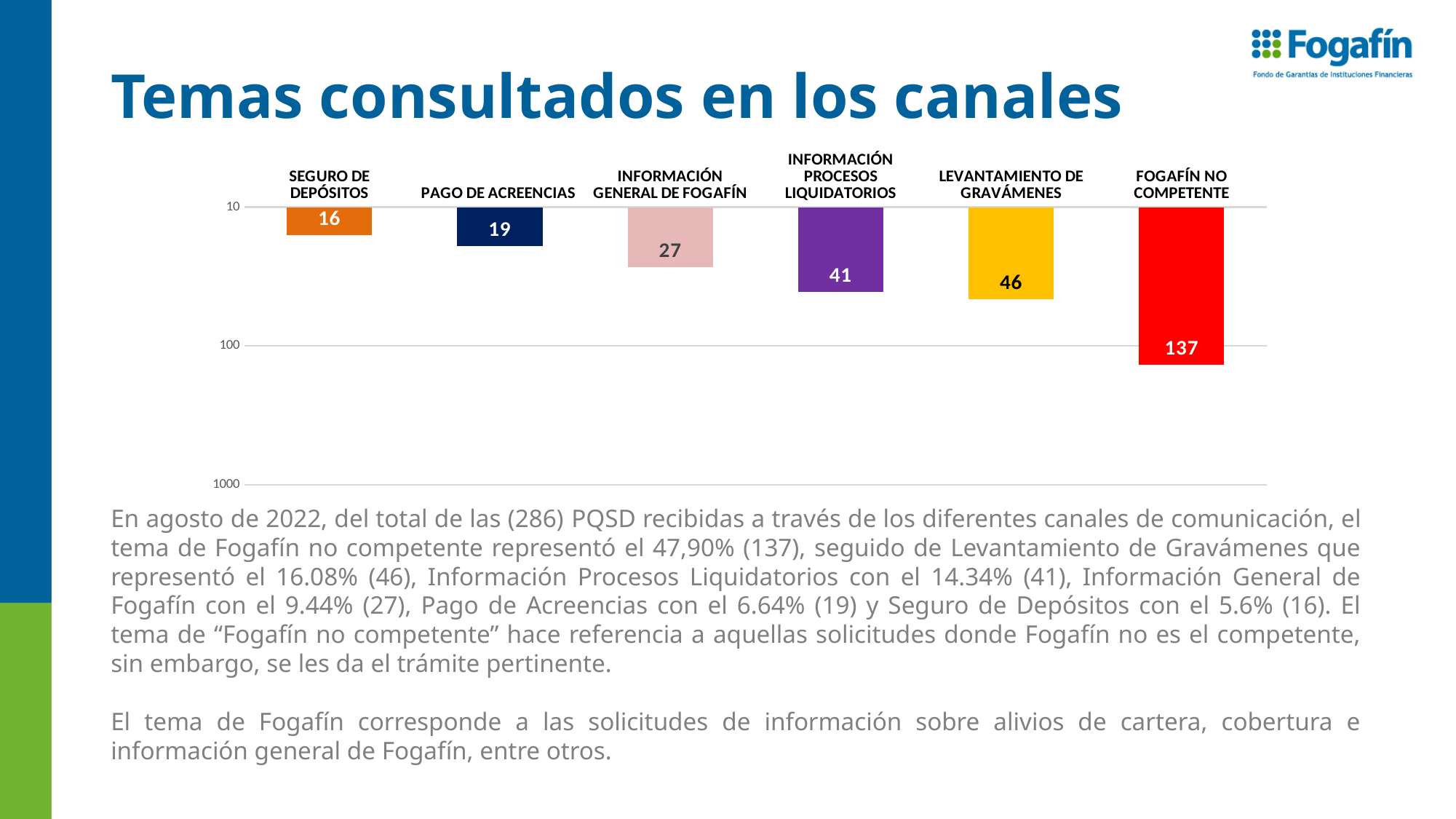
Which is larger, the value for INFORMACIÓN PROCESOS LIQUIDATORIOS or the value for INFORMACIÓN GENERAL DE FOGAFÍN? INFORMACIÓN PROCESOS LIQUIDATORIOS What is the value for LEVANTAMIENTO DE GRAVÁMENES? 46 What is the value for PAGO DE ACREENCIAS? 19 Which category has the highest value? FOGAFÍN NO COMPETENTE What is the difference between the values for FOGAFÍN NO COMPETENTE and LEVANTAMIENTO DE GRAVÁMENES? 91 What is the value for SEGURO DE DEPÓSITOS? 16 Is the value for FOGAFÍN NO COMPETENTE greater or less than 100? greater What is the title of the slide containing the chart? Temas consultados en los canales How many categories are shown in the chart? 6 What kind of chart is shown on the slide? bar chart What is the value for INFORMACIÓN GENERAL DE FOGAFÍN? 27 Which category has the lowest value? SEGURO DE DEPÓSITOS